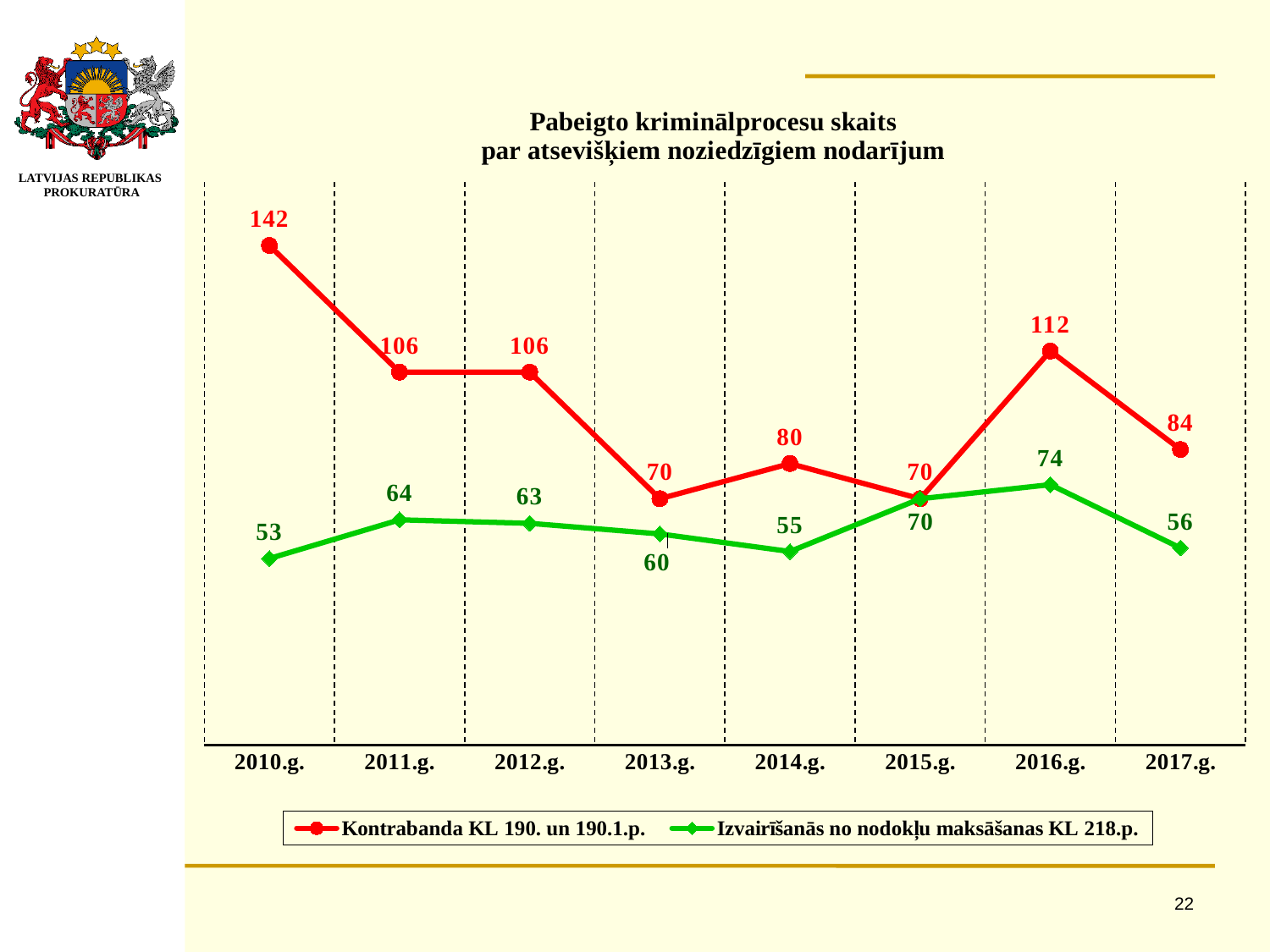
In which year is the Kontrabanda KL 190. un 190.1.p. series highest? 2010.g. Does the Kontrabanda KL 190. un 190.1.p. series rise or fall from 2010.g. to 2013.g.? Fall How many series does the legend list? 2 What colour is the line for Izvairīšanās no nodokļu maksāšanas KL 218.p.? Green Which series has the larger value in 2014.g.? Kontrabanda KL 190. un 190.1.p. How many years are shown on the x axis? 8 What is the value for Izvairīšanās no nodokļu maksāšanas KL 218.p. in 2016.g.? 74 What kind of chart is shown on the slide? Line chart What is the value for Kontrabanda KL 190. un 190.1.p. in 2017.g.? 84 In which year is the Izvairīšanās no nodokļu maksāšanas KL 218.p. series lowest? 2010.g. What is the difference between the Kontrabanda KL 190. un 190.1.p. values in 2016.g. and 2017.g.? 28 What is the value for Kontrabanda KL 190. un 190.1.p. in 2010.g.? 142